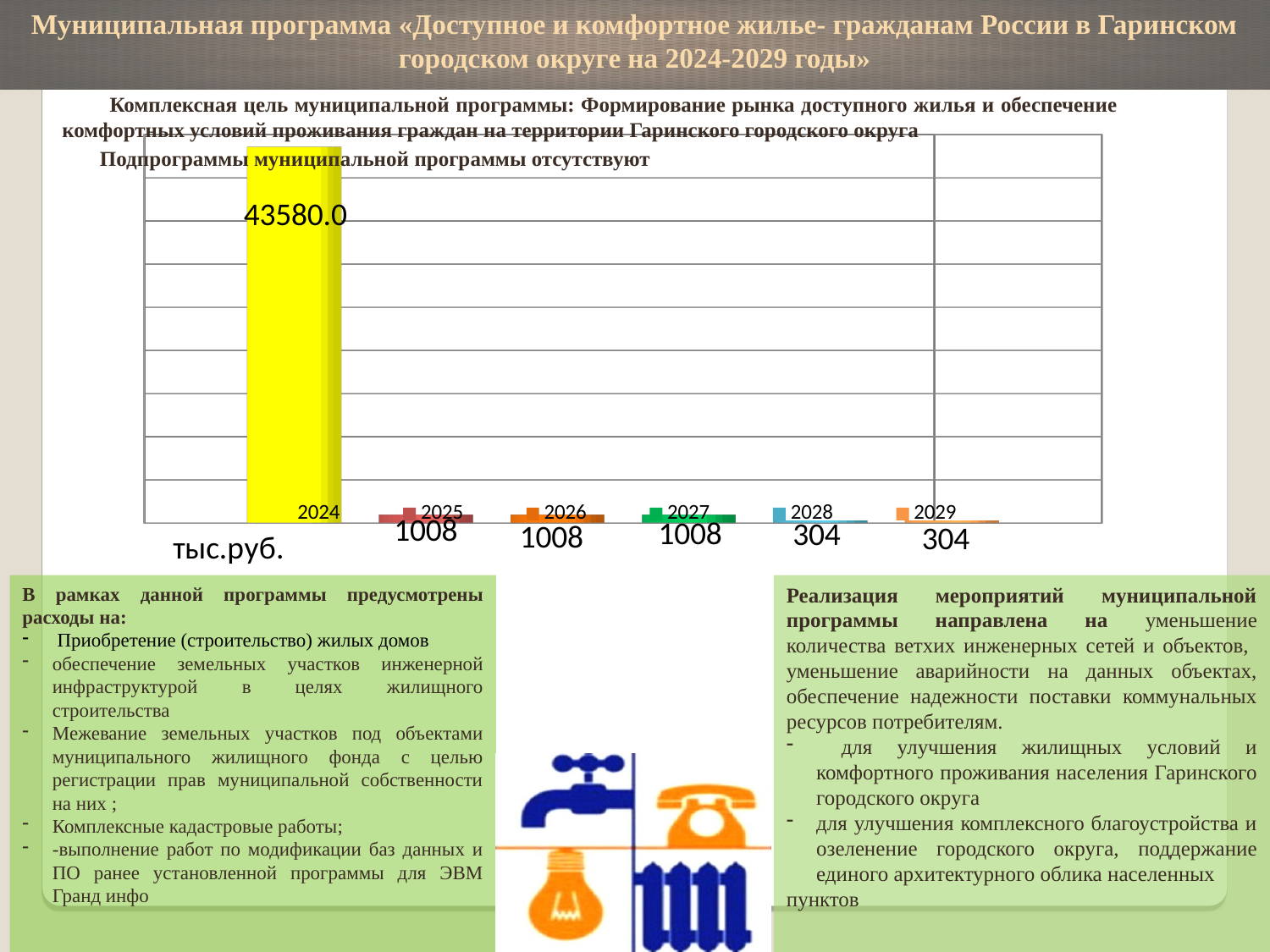
What is the difference between the values for 2027 and 2028? 704 Which is larger, the value for 2026 or the value for 2029? 2026 What is the value for 2024 on the chart? 43580.0 What kind of chart is shown on the slide? bar chart What is the value for 2029 on the chart? 304 Do the values rise or fall from 2024 to 2029 along the x axis? fall How many years (categories) are shown on the chart? 6 Which year has the highest value on the chart? 2024 What is the value for 2028 on the chart? 304 What is the difference between the values for 2024 and 2025? 42572.0 What unit is indicated below the chart? тыс.руб. What is the value for 2025 on the chart? 1008